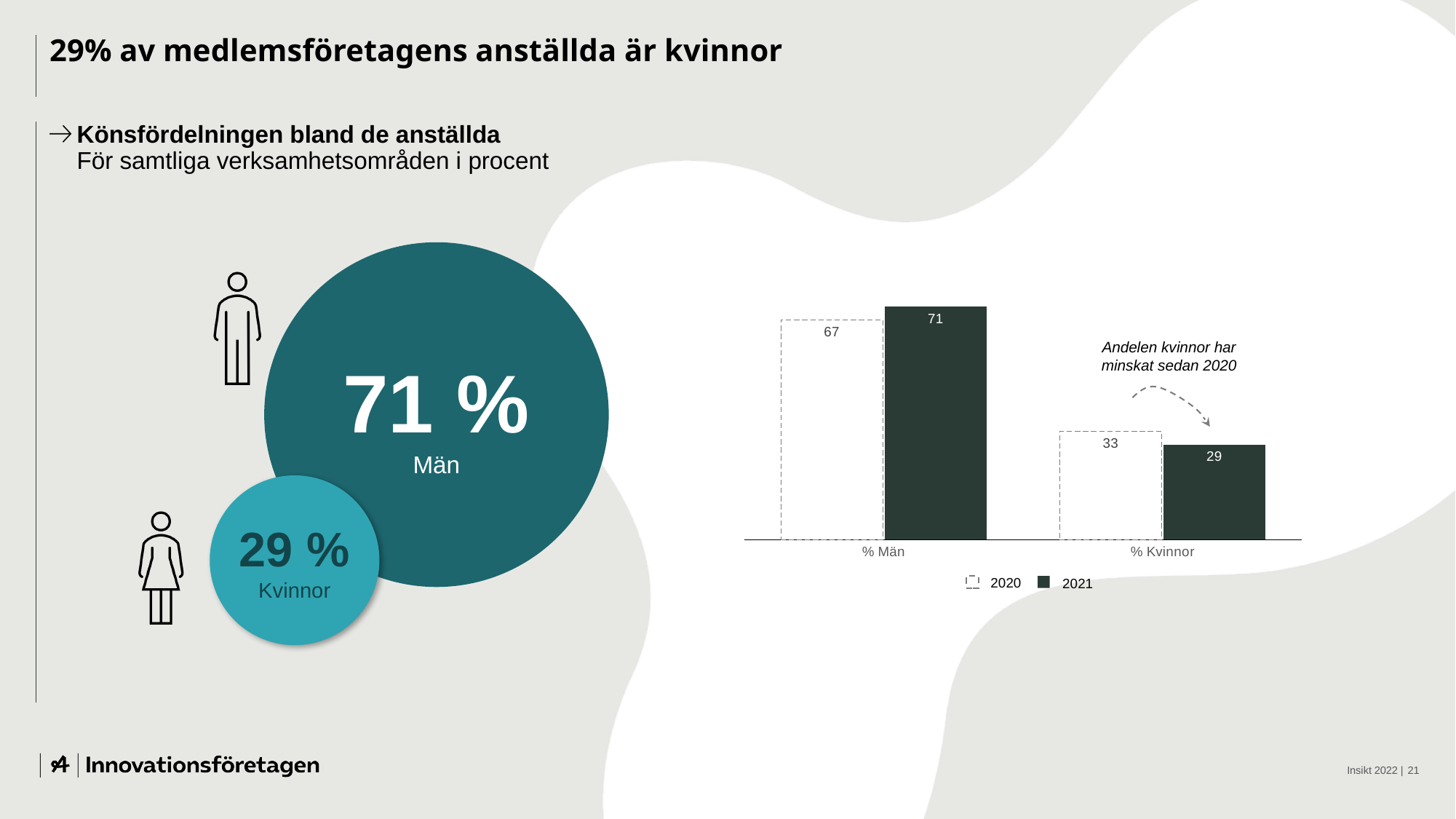
In the bar chart, is the 2021 value for % Män larger or smaller than the 2020 value for % Män? larger What type of chart is shown on the right side of the slide? bar chart In the bar chart, which category has the lowest value in 2020? % Kvinnor In the bar chart, what is the value for % Män in 2020? 67 In the bar chart, what is the difference between the 2021 values for % Män and % Kvinnor? 42 How many categories are shown on the x axis of the bar chart? 2 In the bar chart, what is the value for % Män in 2021? 71 In the bar chart, by how much did the value for % Kvinnor change from 2020 to 2021? 4 In the bar chart, what is the value for % Kvinnor in 2021? 29 How many series does the legend of the bar chart list? 2 In the bar chart, which category has the highest value in 2021? % Män In the bar chart, what is the value for % Kvinnor in 2020? 33